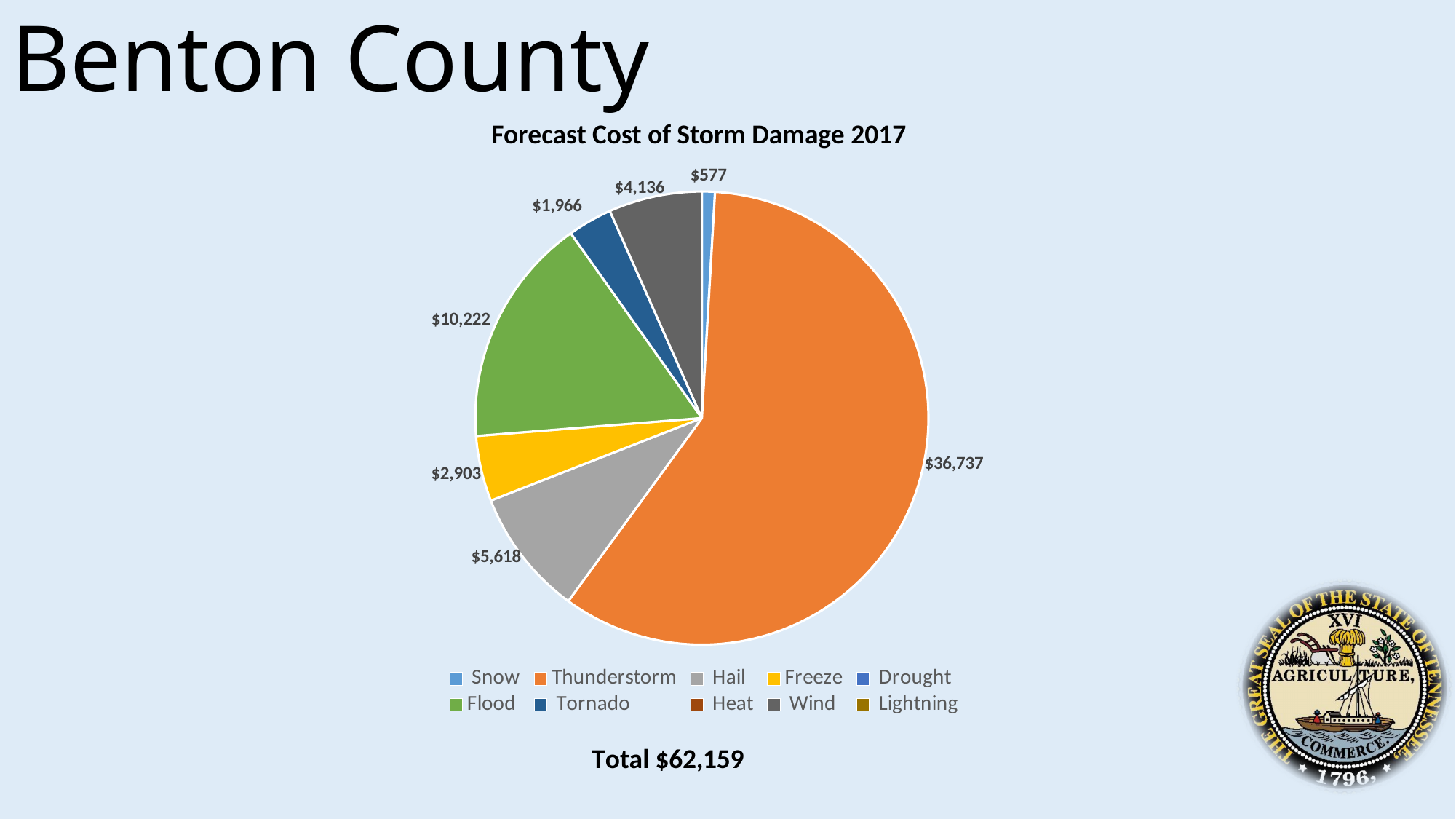
What is the total forecast cost of storm damage shown on the slide? $62,159 What kind of chart is shown on the slide? Pie chart What is the forecast cost of storm damage from Thunderstorm? $36,737 What is the difference between the forecast cost for Flood and the forecast cost for Hail? $4,604 What is the forecast cost of storm damage from Hail? $5,618 What is the forecast cost of storm damage from Wind? $4,136 What is the forecast cost of storm damage from Flood? $10,222 Which has a larger forecast cost of damage, Freeze or Tornado? Freeze What is the forecast cost of storm damage from Snow? $577 Which storm type has the highest forecast cost of damage? Thunderstorm How many storm types does the legend list? 10 Which storm type with a labelled slice has the lowest forecast cost of damage? Snow